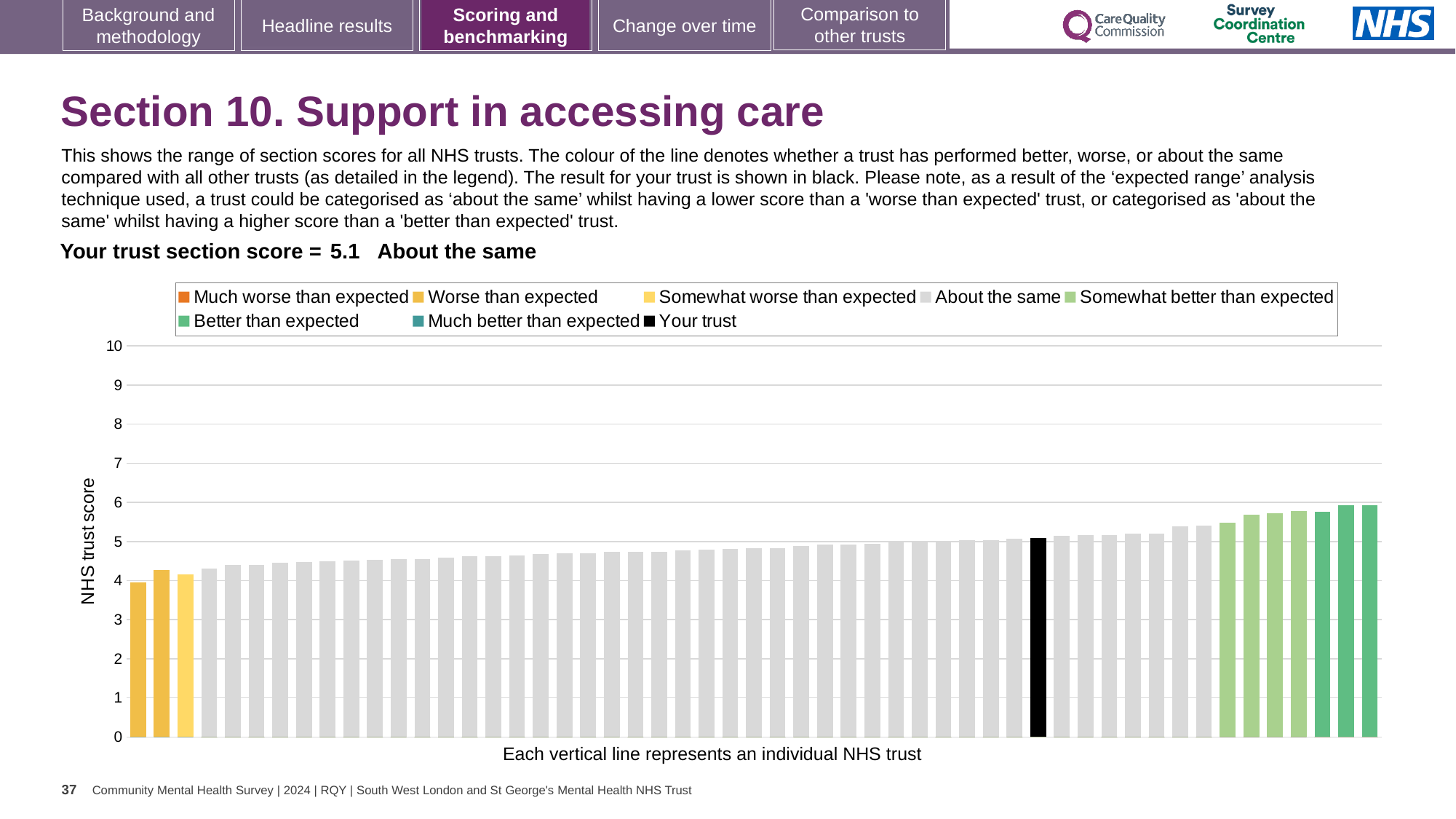
Which category is your trust placed in for Section 10? About the same What kind of chart is shown on the slide? bar chart Is the value for your trust (the black bar) greater or less than 5? greater How many entries does the chart legend list? 8 Is the value of the tallest bar greater or less than 7? less Do the bar values rise or fall from left to right along the x axis? rise What is the section score for your trust shown on the slide? 5.1 What is the label on the vertical axis of the chart? NHS trust score Is the black 'Your trust' bar higher or lower than the tallest 'Better than expected' bar? lower Is the value of the shortest bar greater or less than 5? less What does the caption below the x axis say each vertical line represents? an individual NHS trust How many bars are coloured as 'Worse than expected'? 2